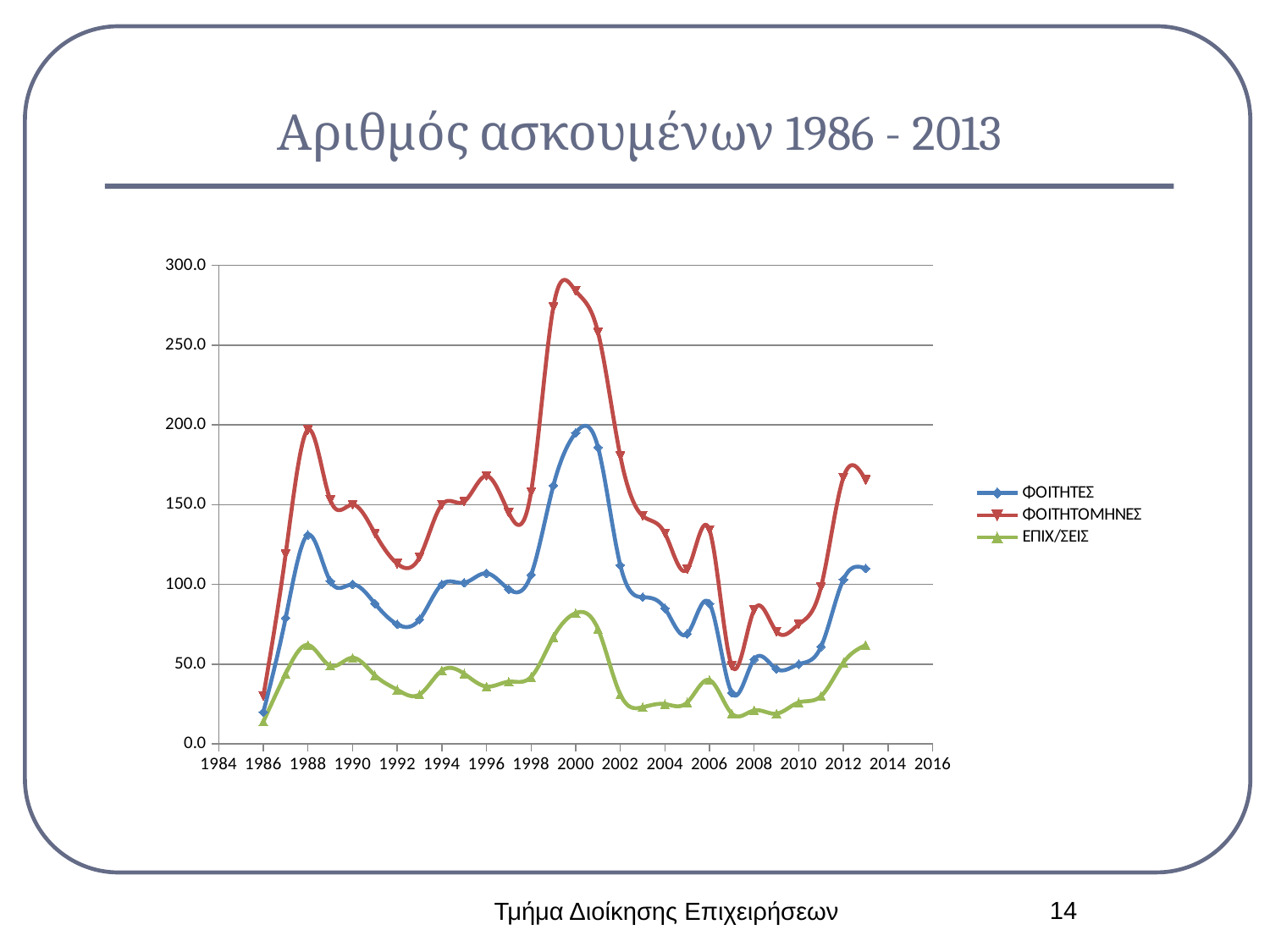
What is the title of the chart? Αριθμός ασκουμένων 1986 - 2013 What are the three series named in the legend? ΦΟΙΤΗΤΕΣ, ΦΟΙΤΗΤΟΜΗΝΕΣ, ΕΠΙΧ/ΣΕΙΣ Which is larger for ΦΟΙΤΗΤΕΣ, the value in 1988 or the value in 1992? 1988 Is the value for ΦΟΙΤΗΤΕΣ in 2007 greater or less than 50? less Is the value for ΕΠΙΧ/ΣΕΙΣ in 2000 greater or less than 100? less Which series has the lowest values across the chart? ΕΠΙΧ/ΣΕΙΣ How many series does the legend list? 3 Is the value for ΦΟΙΤΗΤΕΣ in 2000 greater or less than 150? greater Does the ΦΟΙΤΗΤΕΣ series rise or fall from 2007 to 2013? rise Which series has the highest values across the chart? ΦΟΙΤΗΤΟΜΗΝΕΣ What kind of chart is shown on the slide? line chart